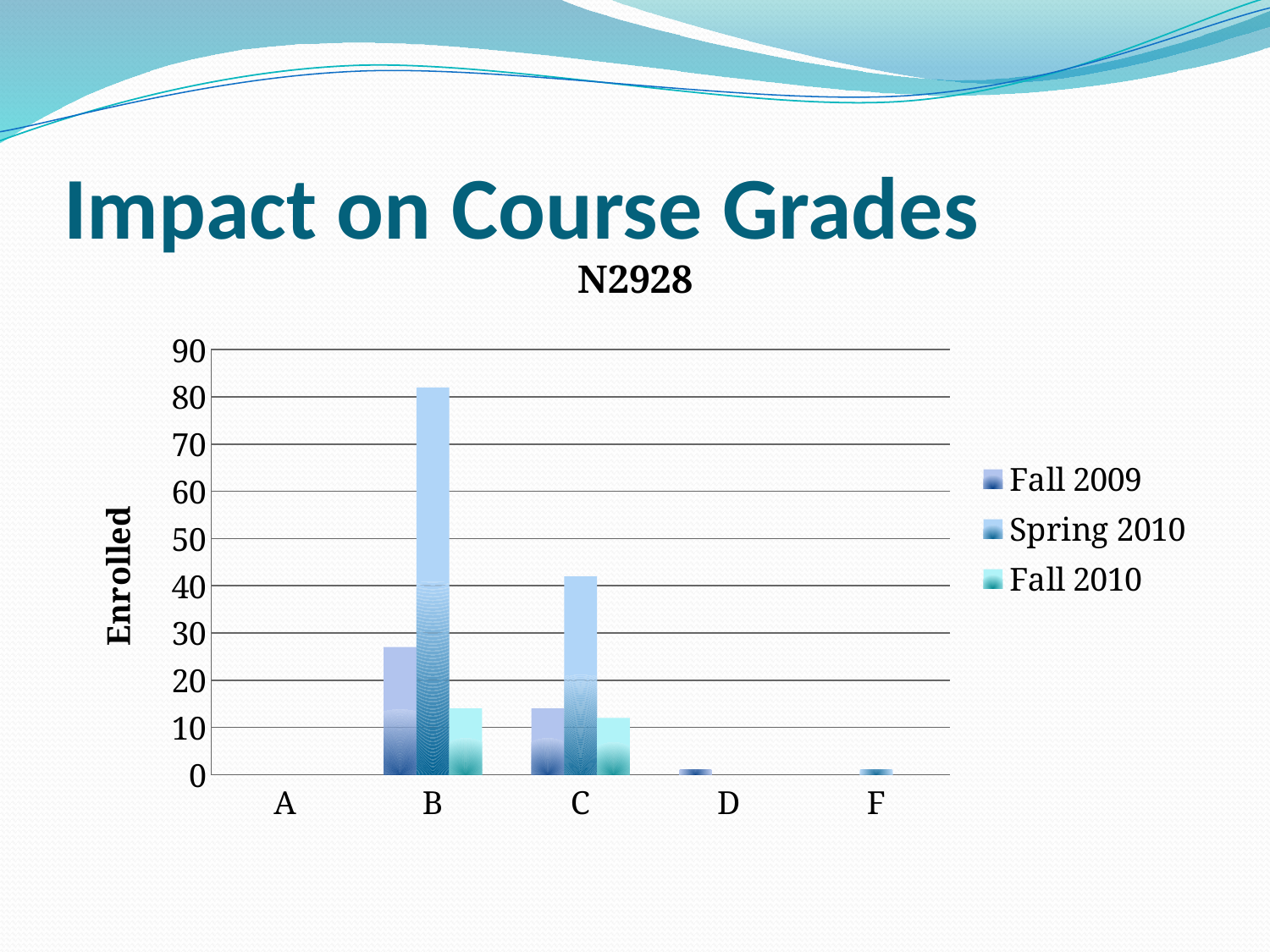
Is the Spring 2010 value for grade B greater or less than 80? greater How many grade categories are shown on the x axis? 5 Is the Fall 2009 value for grade B greater or less than 30? less What is the title of the chart? N2928 For grade C, which series has the larger value, Spring 2010 or Fall 2010? Spring 2010 Which grade category has the highest Spring 2010 value? B What is the label on the y axis? Enrolled Which series has the larger value for grade B, Fall 2009 or Fall 2010? Fall 2009 What kind of chart is shown on the slide? bar chart Which grade category has the highest Fall 2009 value? B How many series does the legend list? 3 Is the Spring 2010 value for grade C greater or less than 40? greater